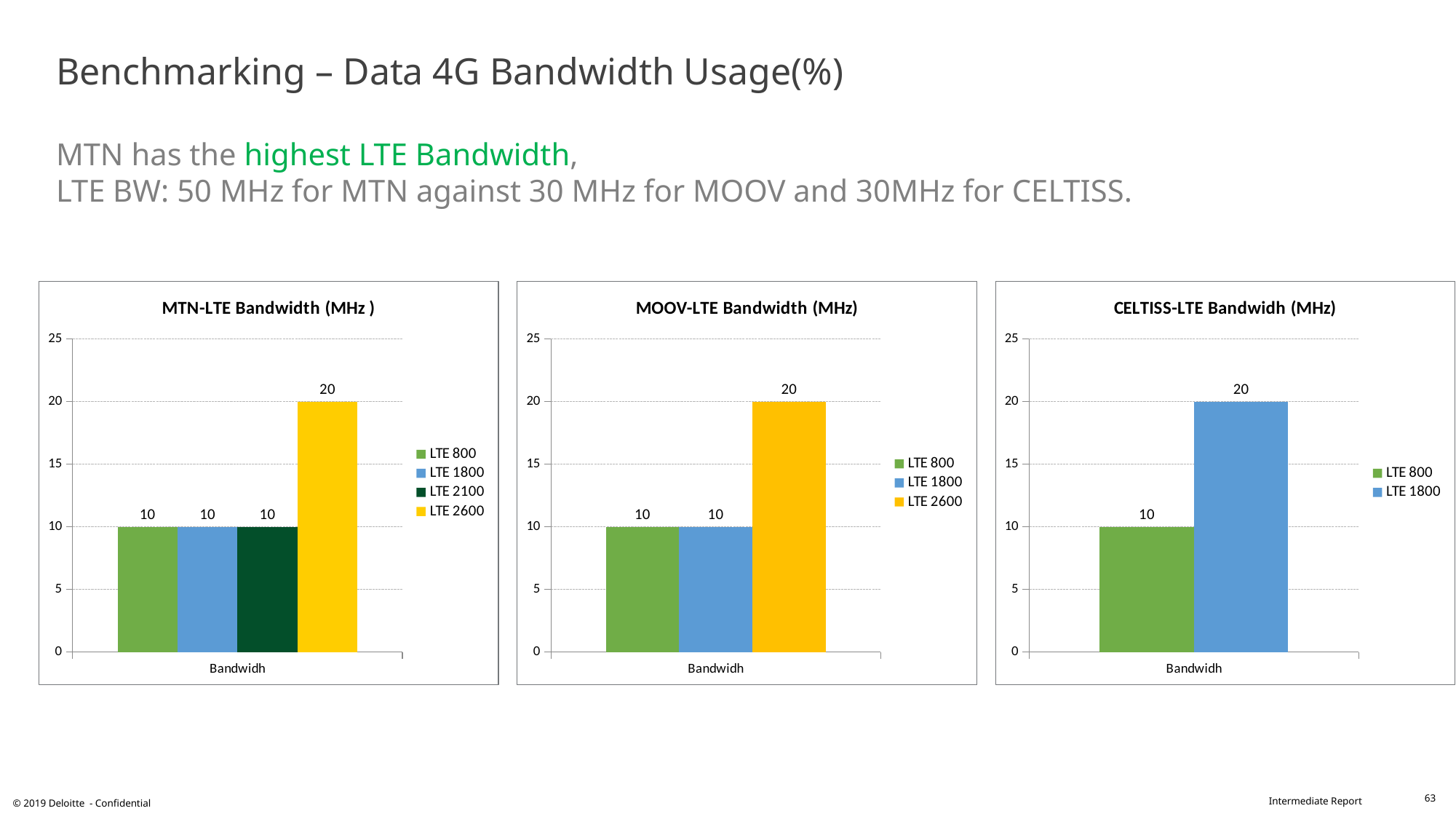
In the MTN-LTE Bandwidth (MHz) chart, what is the value for LTE 2600? 20 In the CELTISS-LTE Bandwidh (MHz) chart, which series has the lowest value? LTE 800 In the MOOV-LTE Bandwidth (MHz) chart, how many series does the legend list? 3 In the CELTISS-LTE Bandwidh (MHz) chart, is the value for LTE 1800 larger or smaller than the value for LTE 800? larger In the MOOV-LTE Bandwidth (MHz) chart, what is the value for LTE 1800? 10 In the MTN-LTE Bandwidth (MHz) chart, how many series does the legend list? 4 In the MOOV-LTE Bandwidth (MHz) chart, what is the difference between the LTE 2600 value and the LTE 800 value? 10 In the MTN-LTE Bandwidth (MHz) chart, which series has the highest value? LTE 2600 In the MTN-LTE Bandwidth (MHz) chart, what colour is the LTE 2600 bar? yellow In the MTN-LTE Bandwidth (MHz) chart, what is the value for LTE 2100? 10 What kind of chart is the MOOV-LTE Bandwidth (MHz) chart? bar chart In the CELTISS-LTE Bandwidh (MHz) chart, what is the value for LTE 1800? 20